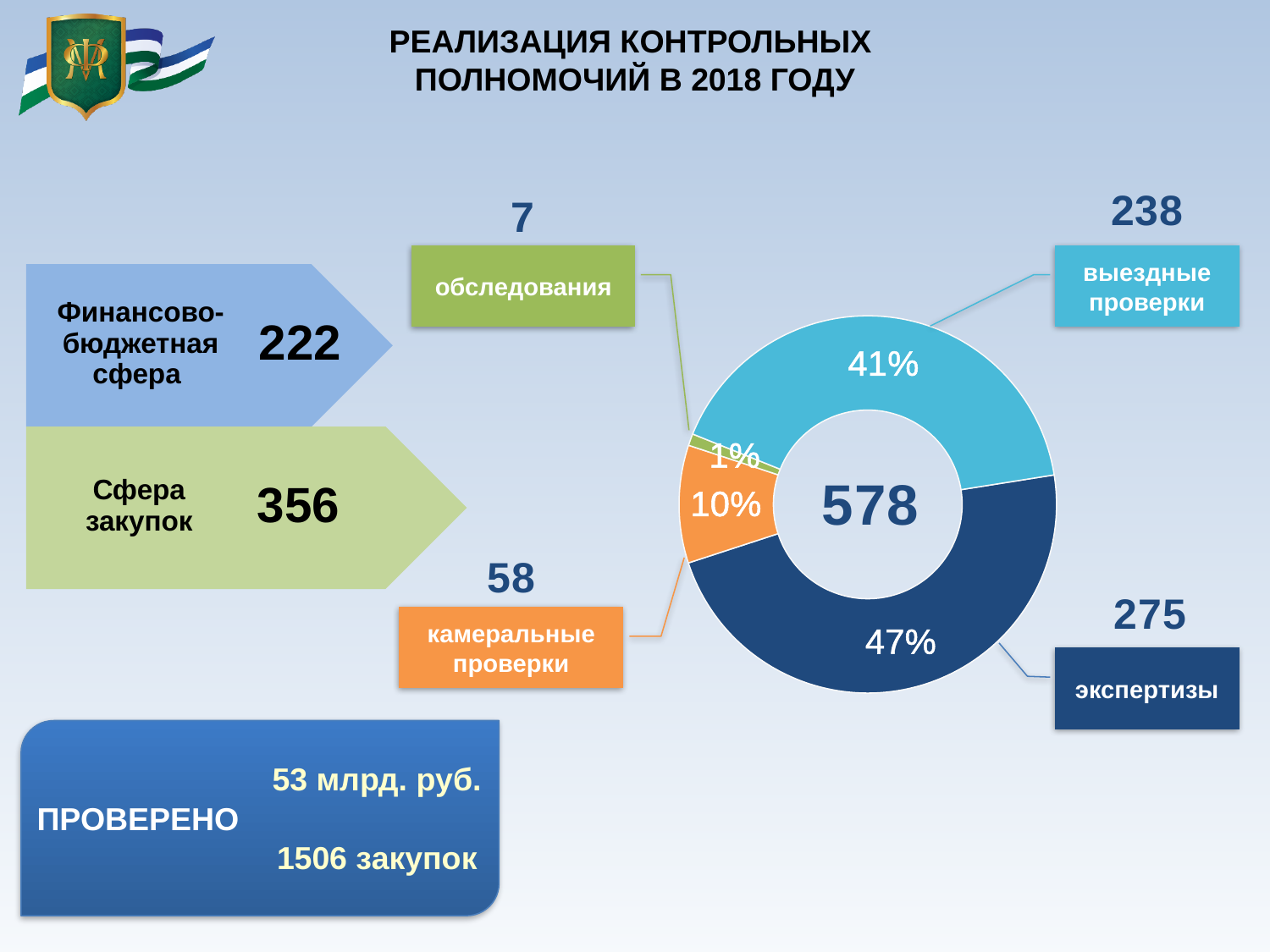
What is the difference between the number for экспертизы and the number for выездные проверки? 37 What share of the doughnut chart does the segment for выездные проверки represent? 41% Which category has the smallest segment in the doughnut chart? обследования What share of the doughnut chart does the segment for экспертизы represent? 47% What number is shown for экспертизы next to the doughnut chart? 275 How many segments does the doughnut chart have? 4 What number is shown in the centre of the doughnut chart? 578 What share of the doughnut chart does the segment for камеральные проверки represent? 10% What kind of chart is shown on the slide? doughnut chart Which category has the largest segment in the doughnut chart? экспертизы What number is shown for выездные проверки next to the doughnut chart? 238